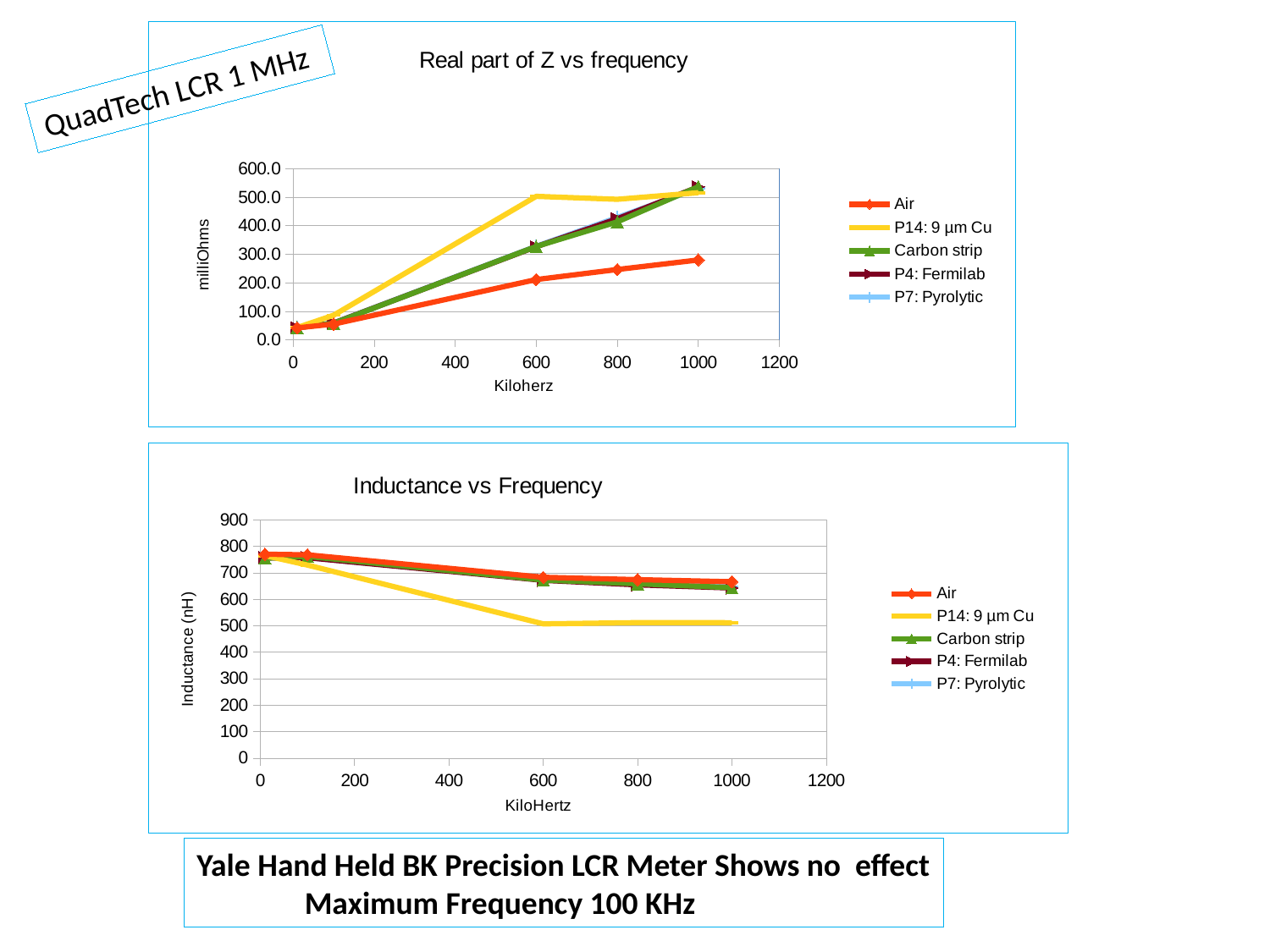
In the 'Real part of Z vs frequency' chart, do the values for Air rise or fall as frequency increases? rise In the 'Inductance vs Frequency' chart, is the value for P14: 9 µm Cu at 1000 kilohertz greater or less than 600? less In the 'Inductance vs Frequency' chart, which is larger at 1000 kilohertz: Air or P14: 9 µm Cu? Air What is the y-axis label of the 'Inductance vs Frequency' chart? Inductance (nH) In the 'Inductance vs Frequency' chart, do the values for P14: 9 µm Cu rise or fall as frequency increases? fall In the 'Real part of Z vs frequency' chart, is the value for P14: 9 µm Cu at 600 kilohertz greater or less than 400.0? greater How many data points are plotted for the Air series in the 'Real part of Z vs frequency' chart? 5 What kind of chart is the 'Real part of Z vs frequency' chart? line chart In the 'Inductance vs Frequency' chart, is the value for Air at 1000 kilohertz greater or less than 600? greater How many series does the legend of the 'Inductance vs Frequency' chart list? 5 In the 'Real part of Z vs frequency' chart, which is larger at 600 kilohertz: P14: 9 µm Cu or Air? P14: 9 µm Cu